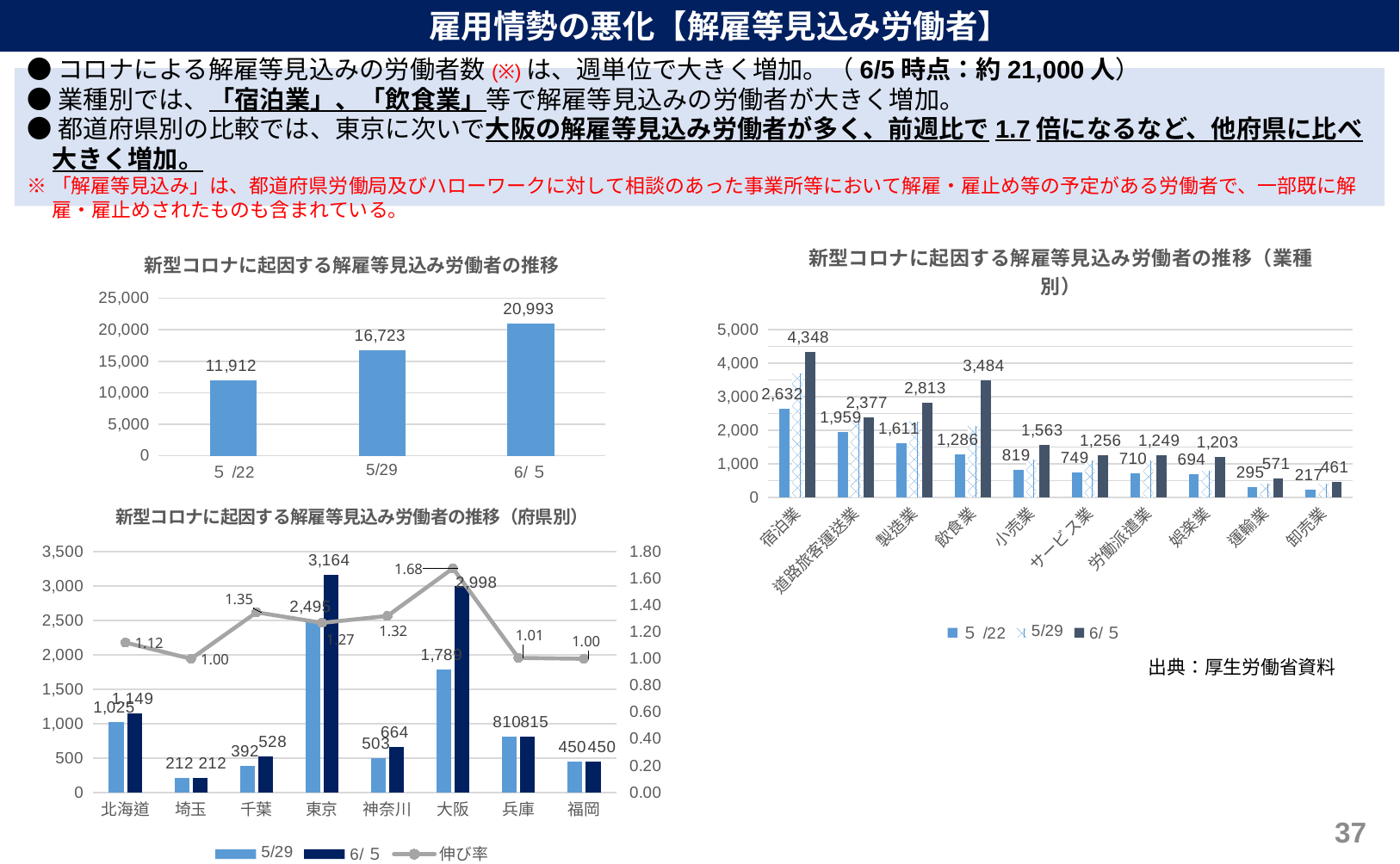
In the chart titled 新型コロナに起因する解雇等見込み労働者の推移（業種別） (right), what is the 6/5 value for 飲食業? 3,484 In the chart titled 新型コロナに起因する解雇等見込み労働者の推移 (top left), what is the value for 6/5? 20,993 In the chart titled 新型コロナに起因する解雇等見込み労働者の推移 (top left), what is the difference between the 6/5 value and the 5/22 value? 9,081 In the chart titled 新型コロナに起因する解雇等見込み労働者の推移（府県別） (bottom left), how many series does the legend list? 3 In the chart titled 新型コロナに起因する解雇等見込み労働者の推移（府県別） (bottom left), what is the 6/5 value for 大阪? 2,998 In the chart titled 新型コロナに起因する解雇等見込み労働者の推移（府県別） (bottom left), how many prefectures are shown on the x axis? 8 In the chart titled 新型コロナに起因する解雇等見込み労働者の推移 (top left), do the values rise or fall from 5/22 to 6/5? rise In the chart titled 新型コロナに起因する解雇等見込み労働者の推移（業種別） (right), which is larger: the 6/5 value for 製造業 or the 6/5 value for 道路旅客運送業? 製造業 In the chart titled 新型コロナに起因する解雇等見込み労働者の推移（業種別） (right), which industry has the highest 6/5 value? 宿泊業 In the chart titled 新型コロナに起因する解雇等見込み労働者の推移（府県別） (bottom left), which prefecture has the lowest 6/5 value? 埼玉 In the chart titled 新型コロナに起因する解雇等見込み労働者の推移（業種別） (right), how many industries are shown on the x axis? 10 In the chart titled 新型コロナに起因する解雇等見込み労働者の推移（府県別） (bottom left), which prefecture has the highest 伸び率? 大阪